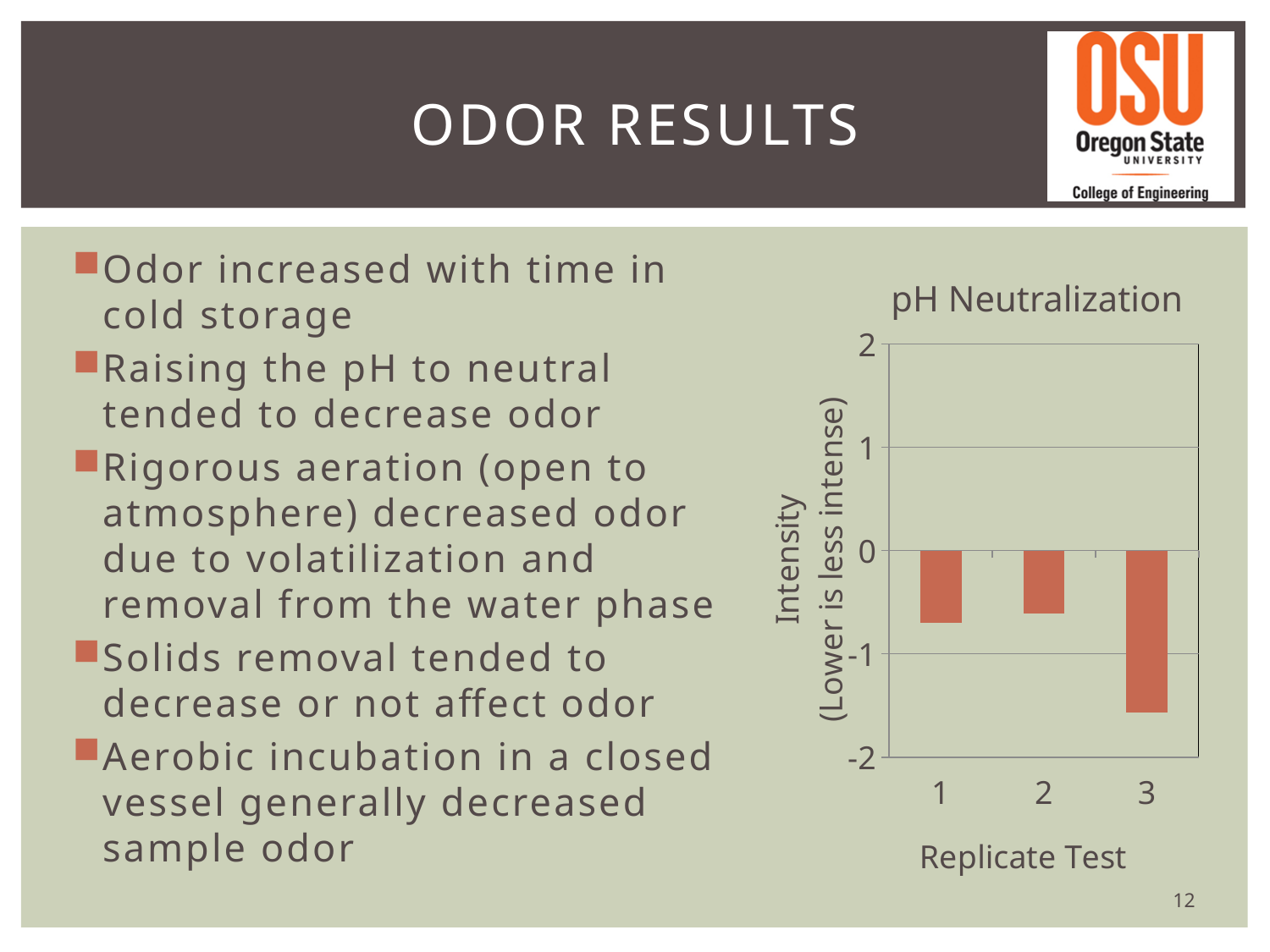
Is the value for replicate test 3 greater or less than -1? less Is the value for replicate test 1 greater or less than -1? greater Which has the larger intensity value, replicate test 1 or replicate test 3? replicate test 1 What is the title of the chart? pH Neutralization Are all the bars in the chart above or below zero? below What is the label of the x axis of the chart? Replicate Test What kind of chart is shown on the slide? bar chart Which has the larger intensity value, replicate test 2 or replicate test 3? replicate test 2 How many replicate tests are plotted in the chart? 3 Which replicate test has the lowest intensity value? 3